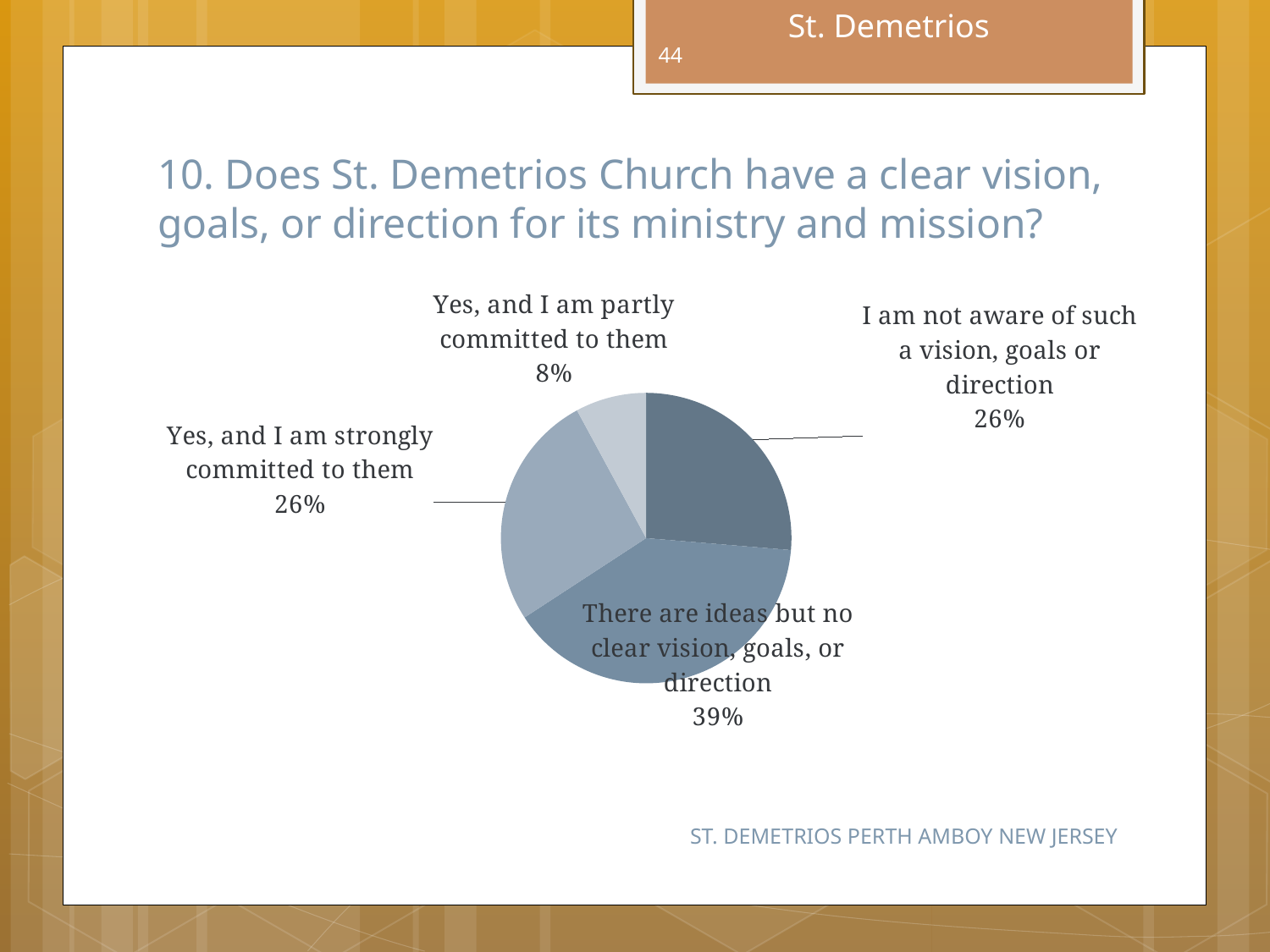
What percentage of respondents said they are not aware of such a vision, goals or direction? 26% What percentage of respondents said there are ideas but no clear vision, goals, or direction? 39% How many slices does the pie chart have? 4 What percentage of respondents said they are partly committed to the vision, goals, or direction? 8% Which is larger: the share for 'Yes, and I am strongly committed to them' or the share for 'Yes, and I am partly committed to them'? Yes, and I am strongly committed to them What kind of chart is shown on the slide? pie chart Which response has the smallest share of the pie? Yes, and I am partly committed to them What question does the chart on the slide present responses to? 10. Does St. Demetrios Church have a clear vision, goals, or direction for its ministry and mission? What is the difference in percentage points between 'There are ideas but no clear vision, goals, or direction' and 'I am not aware of such a vision, goals or direction'? 13 What percentage of respondents said they are strongly committed to the vision, goals, or direction? 26% What is the difference in percentage points between 'There are ideas but no clear vision, goals, or direction' and 'Yes, and I am partly committed to them'? 31 Which response has the largest share of the pie? There are ideas but no clear vision, goals, or direction